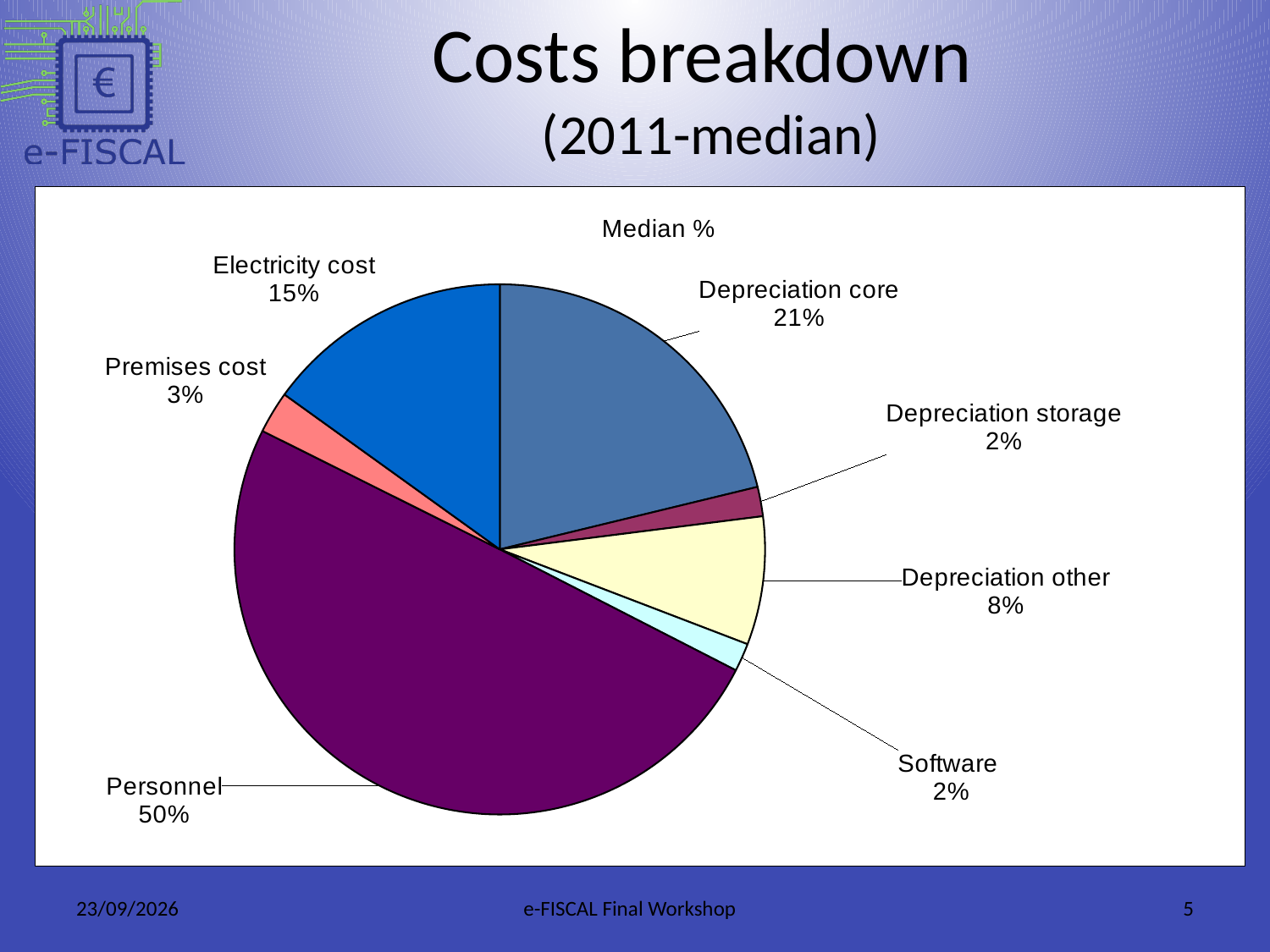
What is the value for Premises cost? 3% What is the value for Depreciation core? 21% What kind of chart is shown on the slide? pie chart What share of the pie does Personnel account for? 50% What is the difference between the Personnel share and the Depreciation core share? 29% Which is larger, Electricity cost or Depreciation other? Electricity cost What is the combined share of Depreciation storage and Software? 4% What is the chart's title? Median % What is the value for Depreciation other? 8% Which category has the largest slice of the pie? Personnel How many slices does the pie chart have? 7 What is the value for Electricity cost? 15%